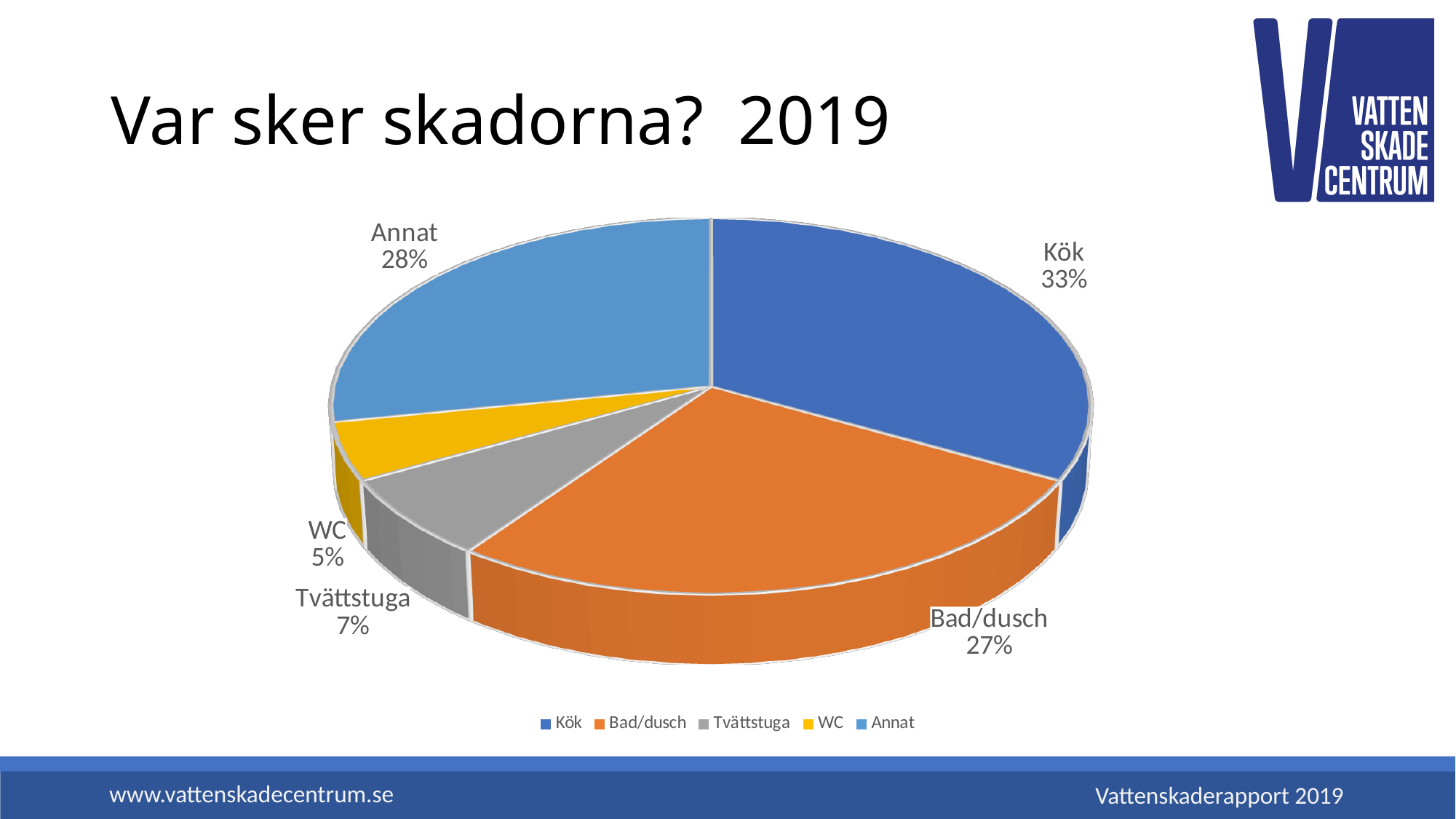
What kind of chart is shown on the slide? Pie chart What is the title of the slide? Var sker skadorna? 2019 What share of the pie does Annat account for? 28% What is the value shown for Bad/dusch? 27% What is the value shown for Tvättstuga? 7% What share of the pie does Kök account for? 33% Which category has the largest slice? Kök Which category has the smallest slice? WC How many categories does the pie chart have? 5 Which is larger, Annat or Bad/dusch? Annat What is the difference in percentage points between Kök and Bad/dusch? 6 percentage points What is the value shown for WC? 5%